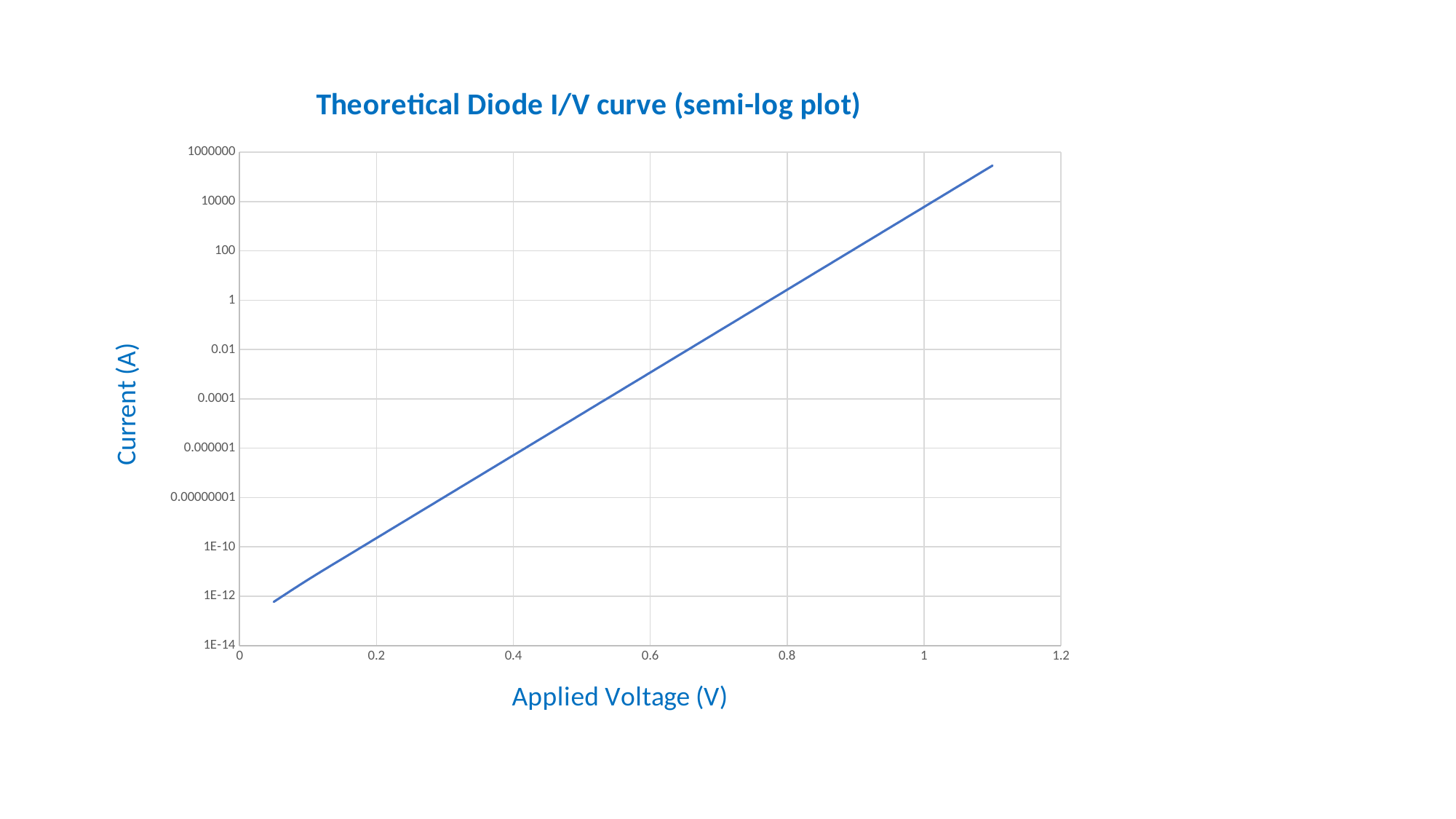
Does the current rise or fall as the applied voltage increases along the x axis? Rise Is the current at an applied voltage of 0.8 V greater or less than 0.01? greater Is the current higher at an applied voltage of 0.4 V or at 0.8 V? 0.8 V Is the current at an applied voltage of 0.4 V greater or less than 0.0001? less What is the label of the vertical axis? Current (A) Is the current at an applied voltage of 0.6 V greater or less than 0.01? less What kind of chart is shown on the slide? Line chart What is the title of the chart? Theoretical Diode I/V curve (semi-log plot)